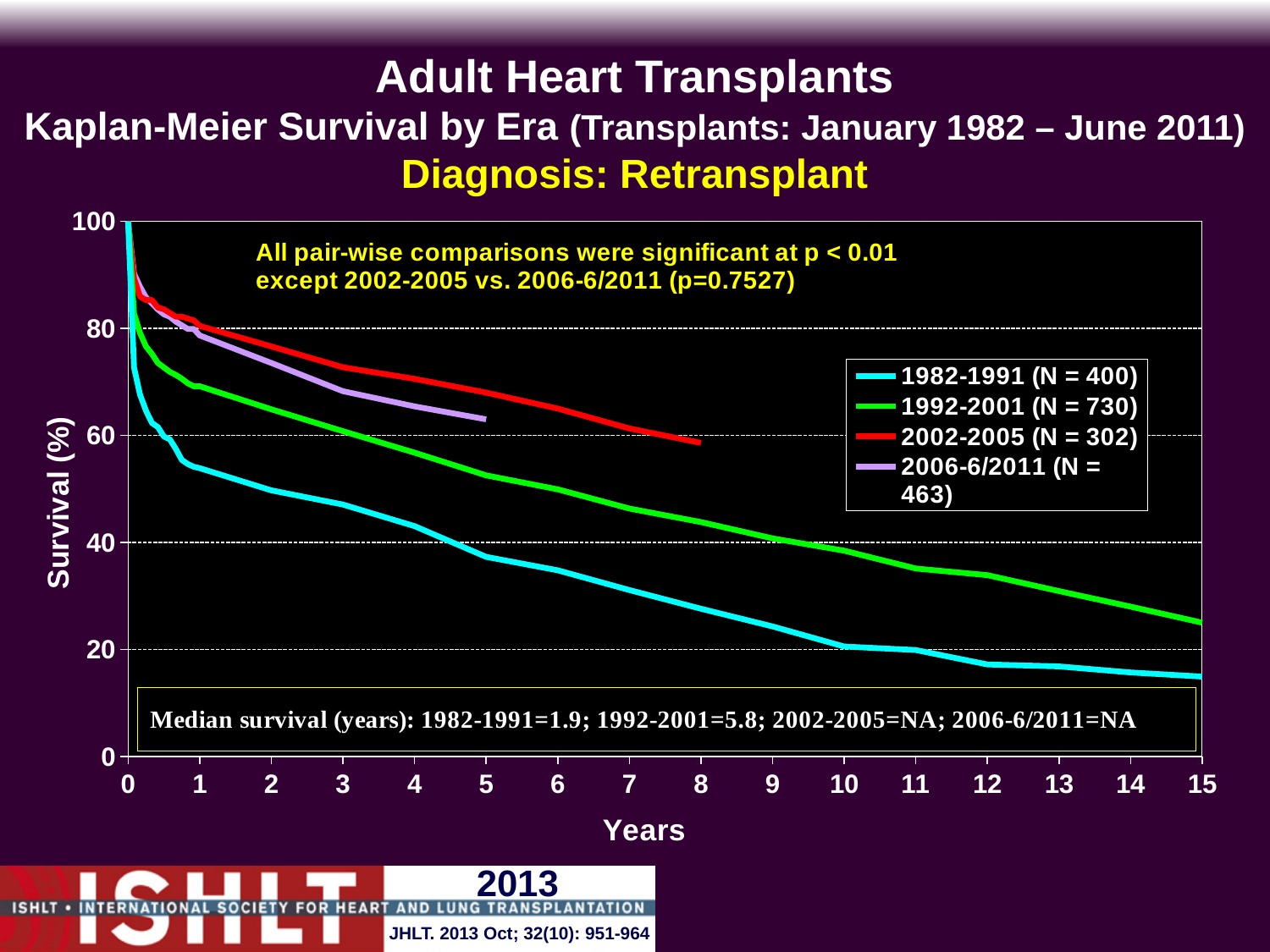
At 5 years, which era has higher survival: 1992-2001 or 1982-1991? 1992-2001 What is the median survival in years for the 1992-2001 era? 5.8 What kind of chart is shown on the slide? line chart Is the survival for the 1982-1991 era at 5 years greater or less than 40? less Which era has the highest survival at 5 years? 2002-2005 Is the survival for the 1992-2001 era at 15 years greater or less than 20? greater Do the survival curves rise or fall as years increase? fall What is the N for the 1982-1991 era shown in the legend? 400 How many series does the legend list? 4 What is the median survival in years for the 1982-1991 era? 1.9 Which era has the lowest survival curve across the chart? 1982-1991 What is the N for the 2006-6/2011 era shown in the legend? 463